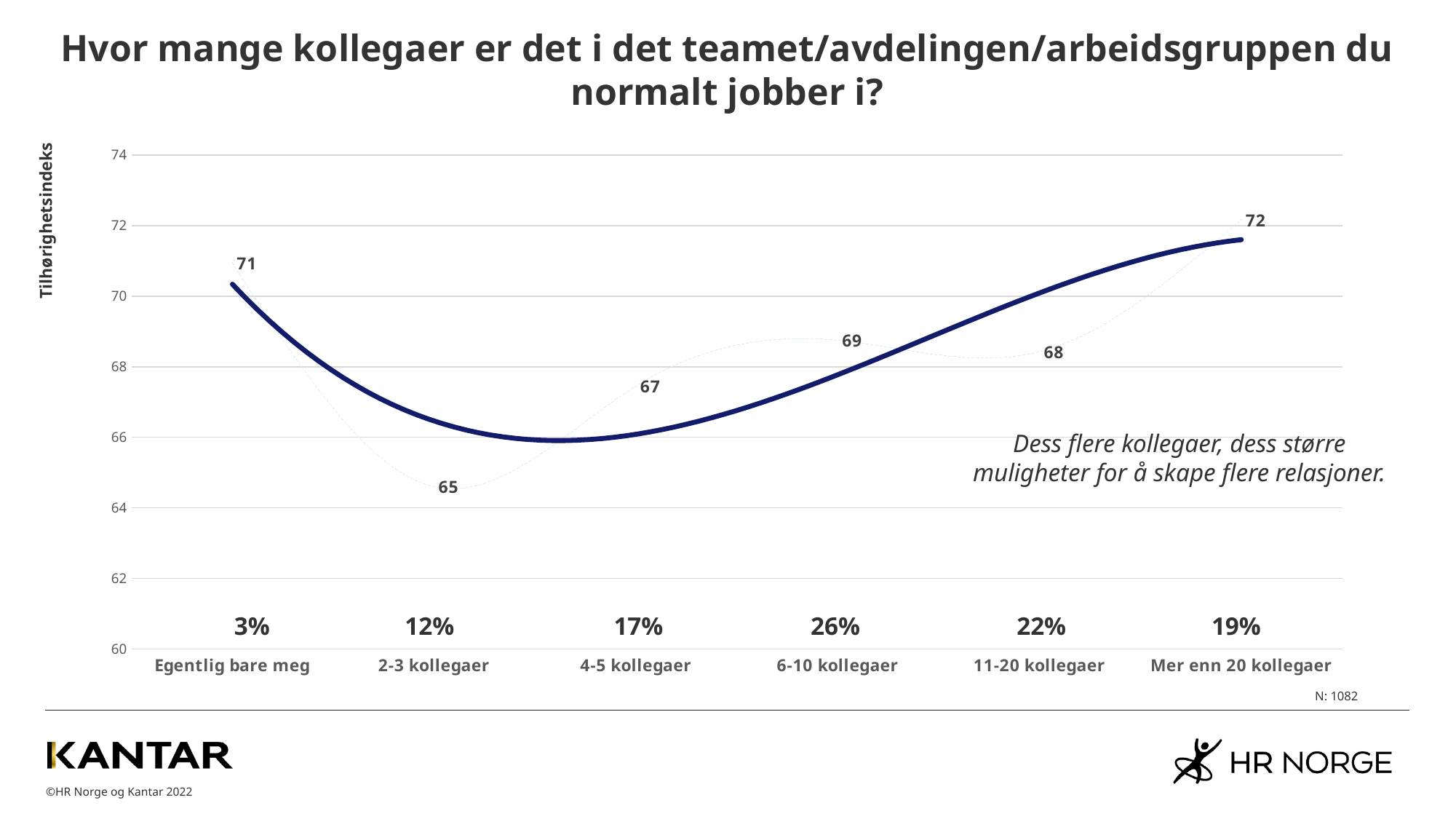
What is the difference between the Tilhørighetsindeks values for "Mer enn 20 kollegaer" and "2-3 kollegaer"? 7 What is the label of the vertical axis of the chart? Tilhørighetsindeks Which category has the highest Tilhørighetsindeks value? Mer enn 20 kollegaer How many categories are shown on the x axis of the chart? 6 What is the Tilhørighetsindeks value for "6-10 kollegaer"? 69 What percentage is shown for the category "Egentlig bare meg"? 3% Which has a higher Tilhørighetsindeks value, "Egentlig bare meg" or "11-20 kollegaer"? Egentlig bare meg What is the Tilhørighetsindeks value for "2-3 kollegaer"? 65 Which category has the lowest Tilhørighetsindeks value? 2-3 kollegaer What percentage is shown for the category "6-10 kollegaer"? 26% What kind of chart is shown on the slide? Line chart What is the Tilhørighetsindeks value for "Mer enn 20 kollegaer"? 72